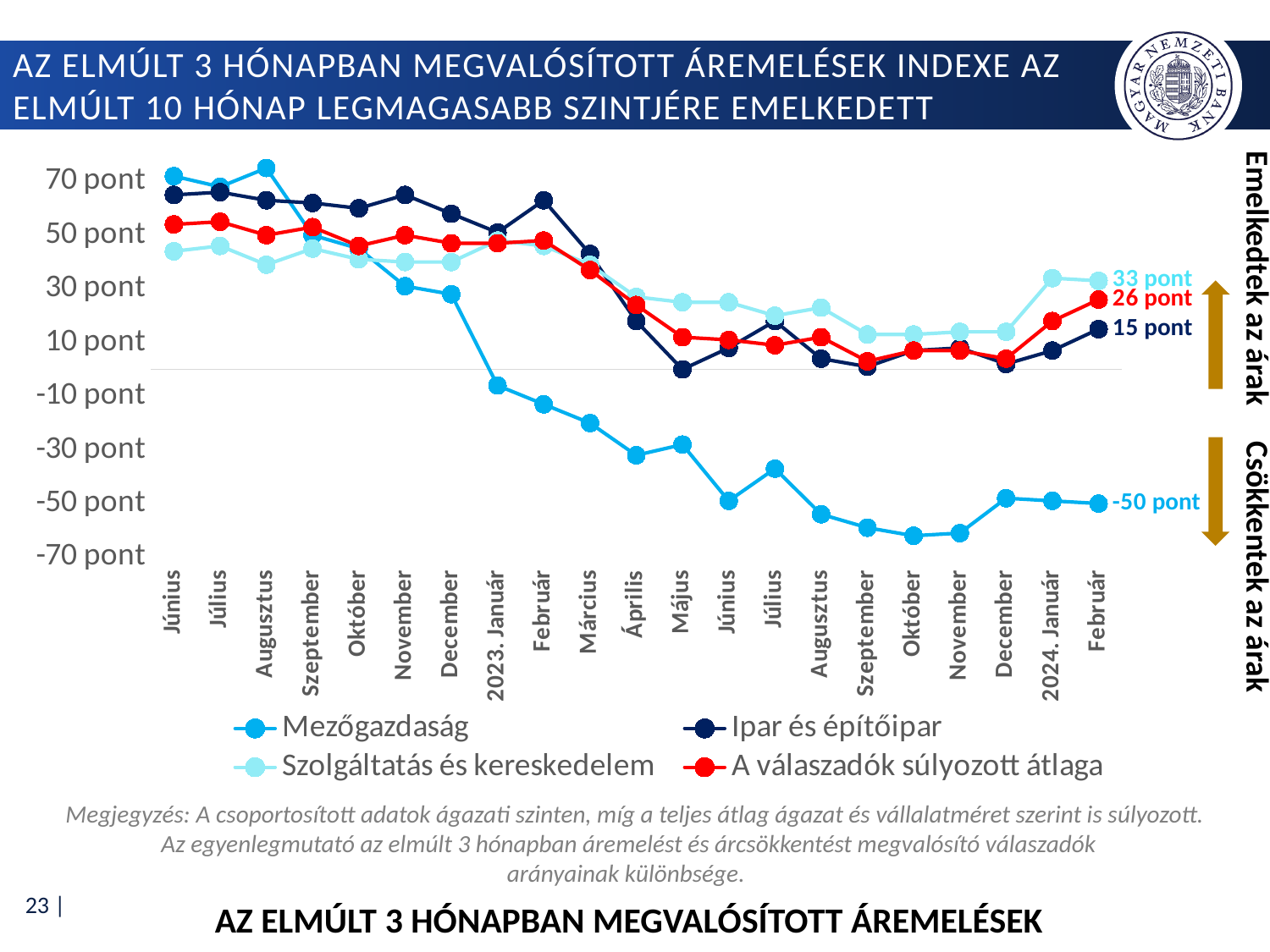
How many series does the legend list? 4 Which series has the lowest value in 2024. Február? Mezőgazdaság Does the Mezőgazdaság series rise or fall overall from the first Június to 2024. Február? Fall How many months are shown on the x axis? 21 What kind of chart is shown on the slide? Line chart Which series has the highest value in 2024. Február? Szolgáltatás és kereskedelem What is the value for Ipar és építőipar in 2024. Február? 15 pont What is the value for Mezőgazdaság in 2024. Február? -50 pont What is the value for Szolgáltatás és kereskedelem in 2024. Február? 33 pont What is the difference between Szolgáltatás és kereskedelem and Ipar és építőipar in 2024. Február? 18 pont Is the value for Mezőgazdaság in the first Június greater or less than 50 pont? greater What is the value for A válaszadók súlyozott átlaga in 2024. Február? 26 pont